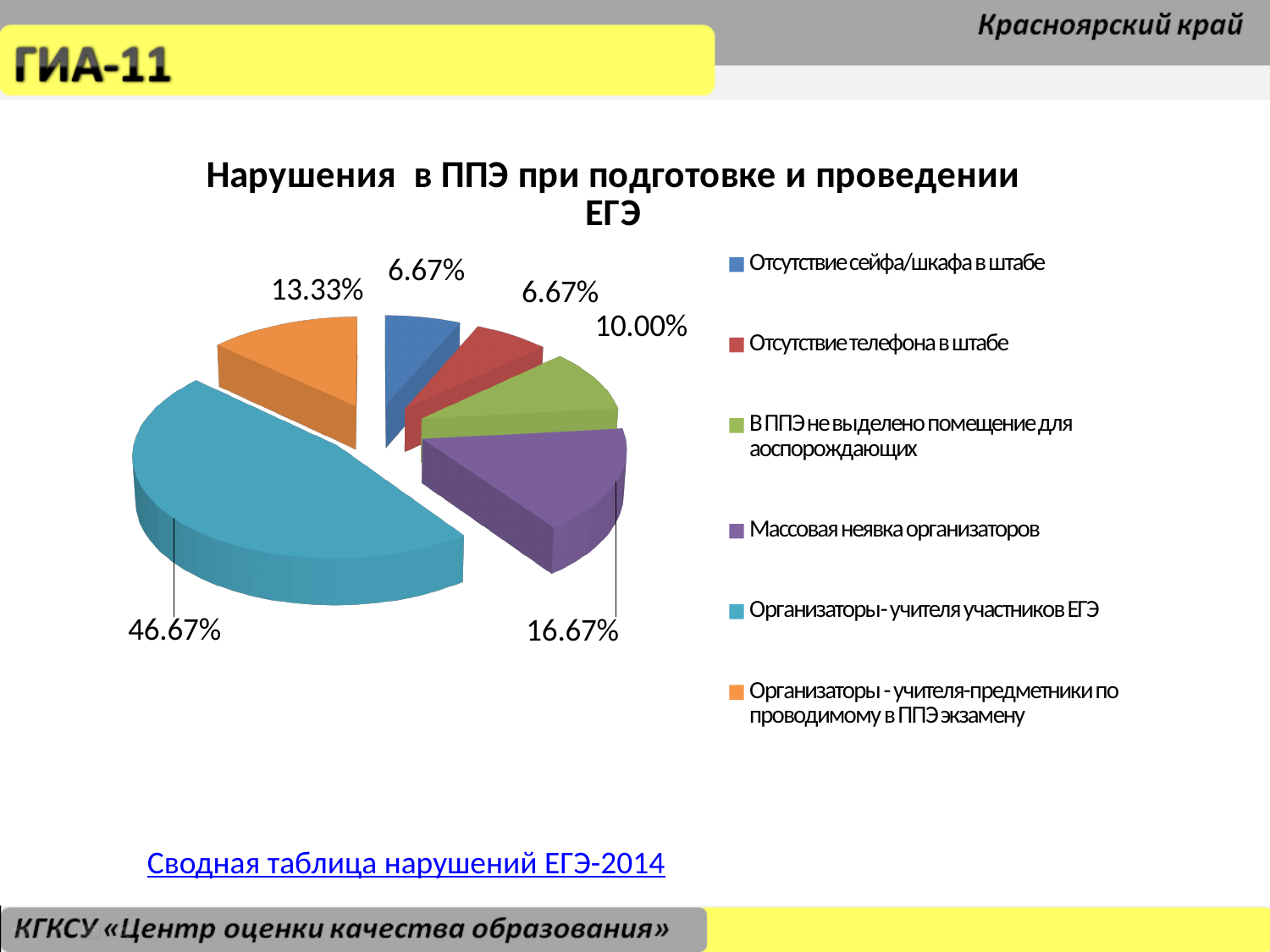
What is the difference between the share for 'Организаторы - учителя участников ЕГЭ' and the share for 'Массовая неявка организаторов'? 30.00% Which is larger: the share for 'Массовая неявка организаторов' or the share for 'Организаторы - учителя-предметники по проводимому в ППЭ экзамену'? Массовая неявка организаторов What share of the pie is 'В ППЭ не выделено помещение для аоспорождающих'? 10.00% What share of the pie is 'Организаторы - учителя участников ЕГЭ'? 46.67% How many categories does the legend of the pie chart list? 6 What share of the pie is 'Массовая неявка организаторов'? 16.67% What kind of chart is shown on the slide? pie chart What colour is the slice for 'Отсутствие телефона в штабе'? red What is the title of the chart? Нарушения в ППЭ при подготовке и проведении ЕГЭ Which category has the largest share of the pie? Организаторы - учителя участников ЕГЭ